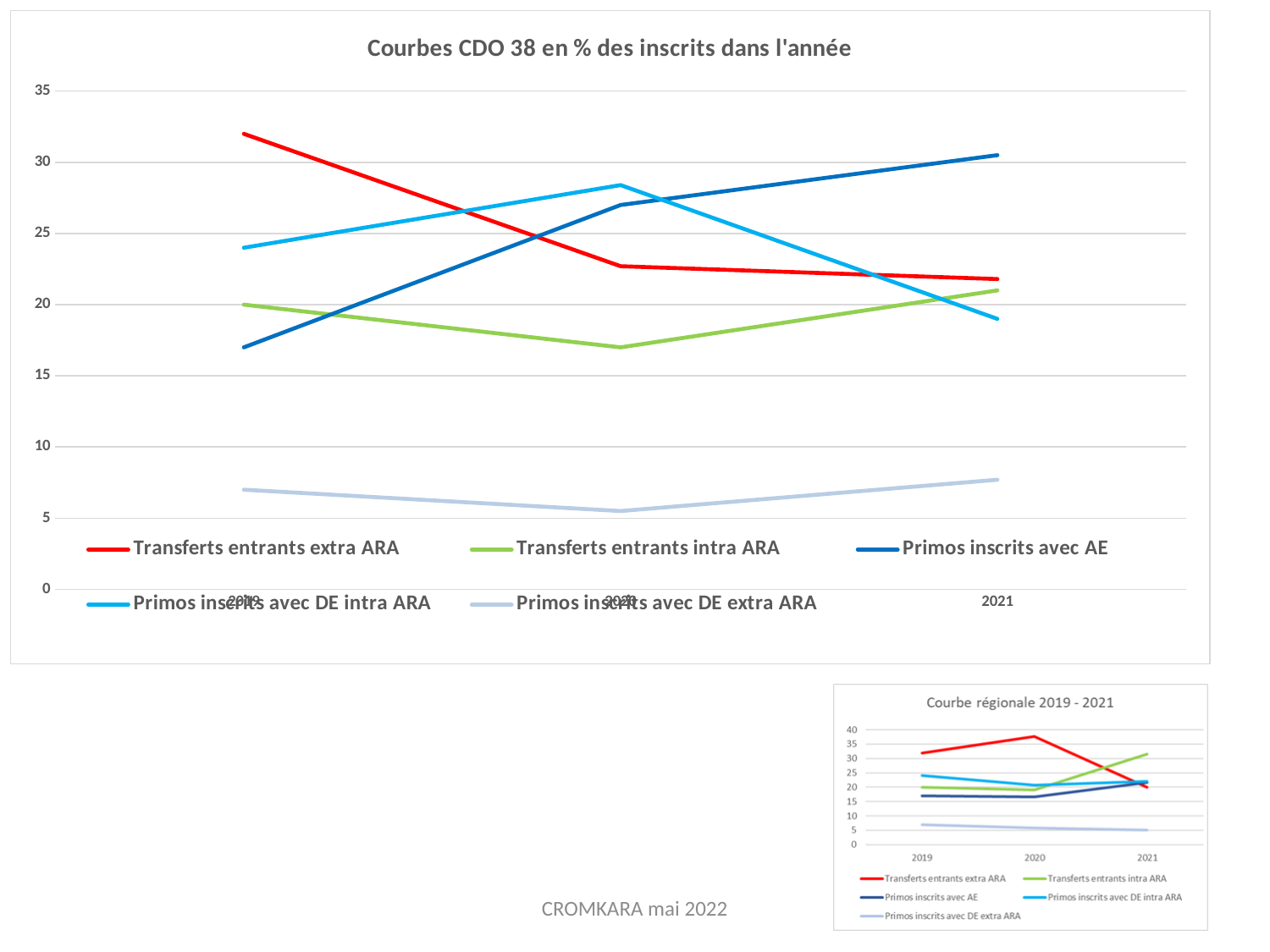
On the chart titled 'Courbes CDO 38 en % des inscrits dans l'année', how many years are shown on the x axis? 3 On the chart titled 'Courbes CDO 38 en % des inscrits dans l'année', what kind of chart is shown? line chart On the chart titled 'Courbes CDO 38 en % des inscrits dans l'année', is the value for 'Primos inscrits avec DE extra ARA' in 2020 greater or less than 10? less On the chart titled 'Courbes CDO 38 en % des inscrits dans l'année', does the 'Transferts entrants extra ARA' line rise or fall from 2019 to 2021? fall What is the title of the small chart at the bottom right of the slide? Courbe régionale 2019 - 2021 On the chart titled 'Courbes CDO 38 en % des inscrits dans l'année', is the value for 'Primos inscrits avec AE' in 2019 greater or less than 20? less On the chart titled 'Courbes CDO 38 en % des inscrits dans l'année', how many series does the legend list? 5 On the chart titled 'Courbes CDO 38 en % des inscrits dans l'année', is the value for 'Transferts entrants extra ARA' in 2019 greater or less than 30? greater On the chart titled 'Courbes CDO 38 en % des inscrits dans l'année', which series has the lowest value in 2020? Primos inscrits avec DE extra ARA On the chart titled 'Courbes CDO 38 en % des inscrits dans l'année', in 2020 which is larger: 'Primos inscrits avec DE intra ARA' or 'Transferts entrants extra ARA'? Primos inscrits avec DE intra ARA On the chart titled 'Courbes CDO 38 en % des inscrits dans l'année', which series has the highest value in 2021? Primos inscrits avec AE On the chart titled 'Courbes CDO 38 en % des inscrits dans l'année', does the 'Primos inscrits avec AE' line rise or fall from 2019 to 2021? rise